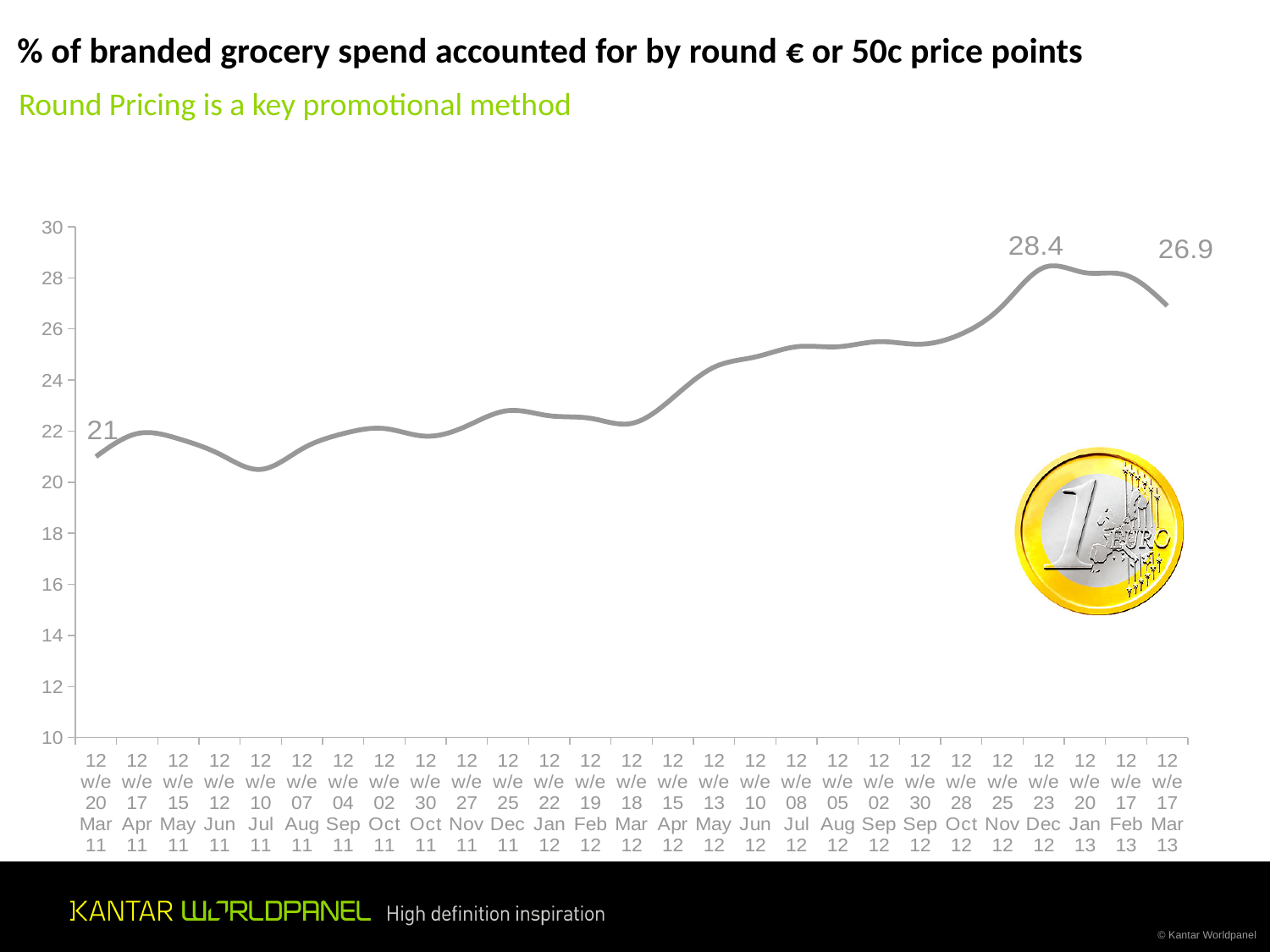
What is the value for 12 w/e 20 Mar 11? 21 By how much did the value increase from 12 w/e 20 Mar 11 to 12 w/e 23 Dec 12? 7.4 Which period has the highest value on the chart? 12 w/e 23 Dec 12 Is the value for 12 w/e 10 Jul 11 greater or less than 22? less Which period has the lowest value on the chart? 12 w/e 10 Jul 11 How many 12-week periods are plotted on the x axis? 27 What is the value for 12 w/e 17 Mar 13? 26.9 What is the value for 12 w/e 23 Dec 12? 28.4 What is the difference between the values for 12 w/e 23 Dec 12 and 12 w/e 17 Mar 13? 1.5 Which is larger, the value for 12 w/e 23 Dec 12 or for 12 w/e 17 Mar 13? 12 w/e 23 Dec 12 What kind of chart is shown on the slide? Line chart Is the value for 12 w/e 10 Jun 12 greater or less than 24? greater